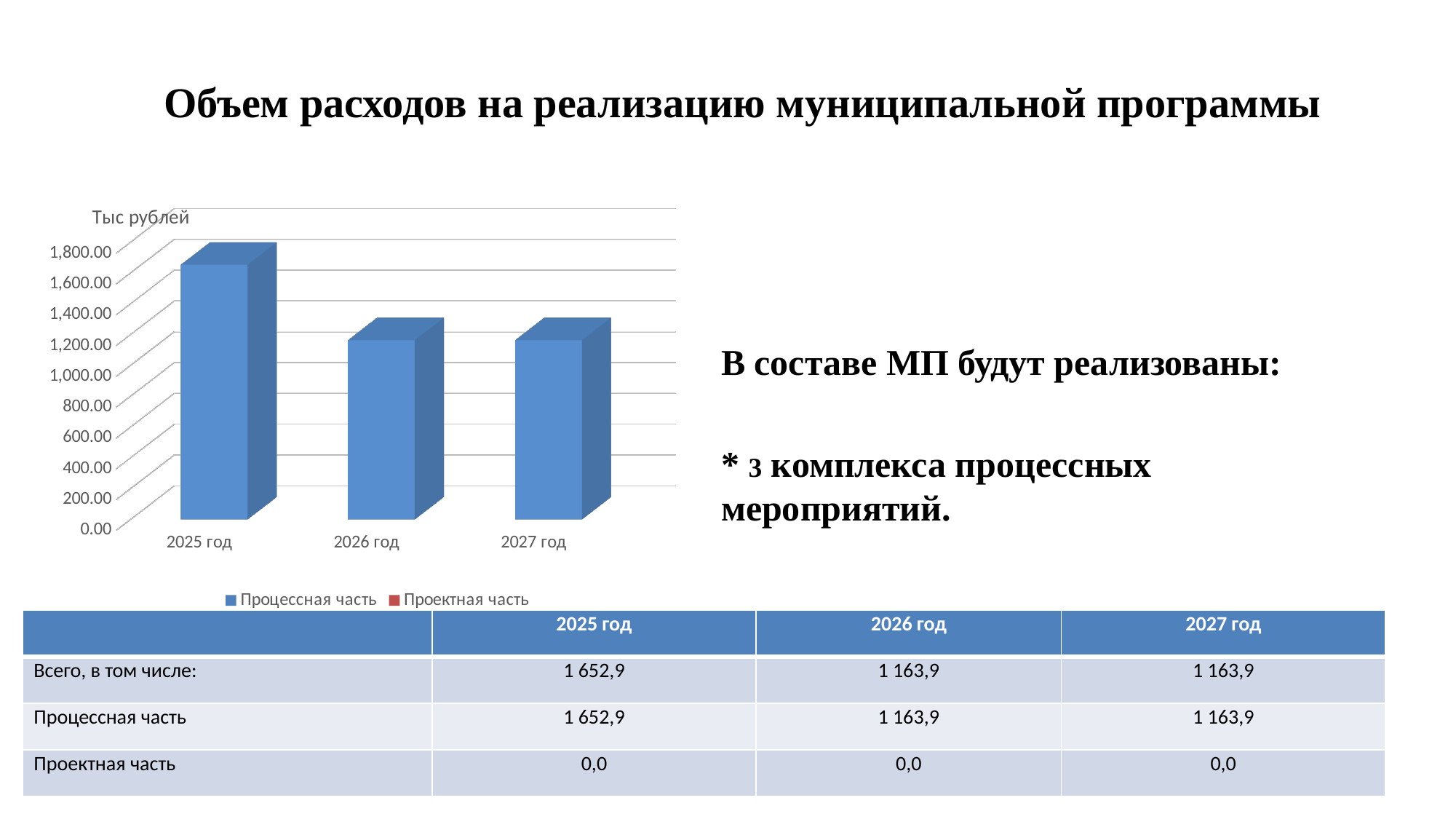
How many years (categories) are shown on the x axis of the chart? 3 Do the bar values rise or fall from 2025 год to 2027 год? fall Which is larger, the bar for 2025 год or the bar for 2026 год? 2025 год What unit label is shown at the top of the chart's vertical axis? Тыс рублей Is the value for 2027 год greater or less than 1,000.00? greater How many series does the chart legend list? 2 According to the table under the chart, what is the value of Проектная часть for 2027 год? 0,0 What kind of chart is shown on the slide? bar chart According to the table under the chart, what is the value of Процессная часть for 2025 год? 1 652,9 Is the value for 2025 год greater or less than 1,400.00? greater Is the value for 2026 год greater or less than 1,400.00? less Which year has the highest bar in the chart? 2025 год